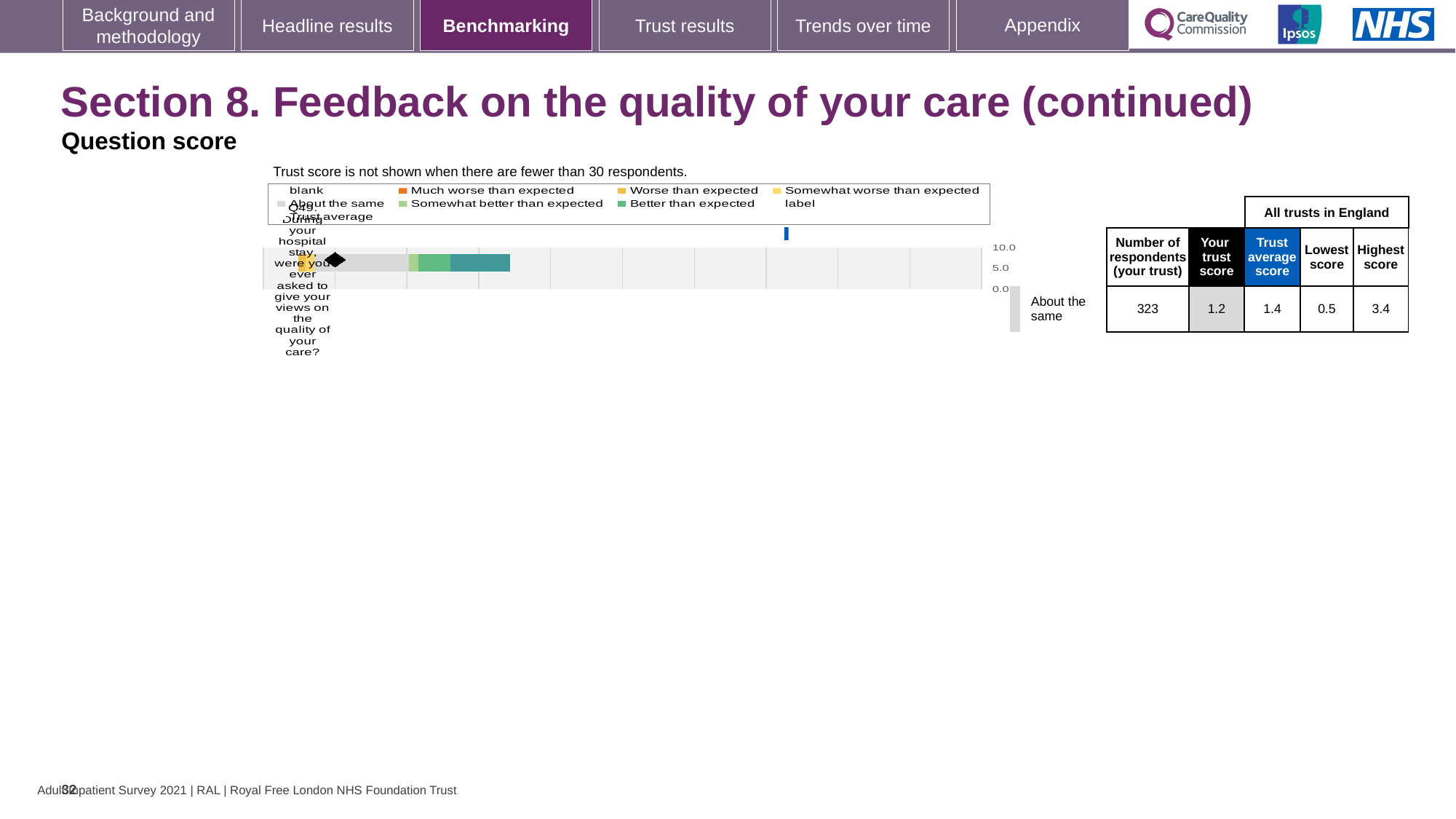
How many survey questions are plotted on the chart? 1 What benchmark category is the trust's Q49 result labelled as? About the same What is the lowest score among all trusts in England for Q49? 0.5 What is the highest score among all trusts in England for Q49? 3.4 What is the trust average score for Q49? 1.4 What is the trust score for Q49 shown in the table next to the chart? 1.2 Which is larger for Q49: the trust's own score or the trust average score? Trust average score By how much does the trust average score exceed the trust's own score for Q49? 0.2 How many respondents from the trust answered Q49? 323 What kind of chart is used to show the Q49 benchmarking result? bar chart According to the note above the chart, when is the trust score not shown? When there are fewer than 30 respondents What is the difference between the highest and lowest scores for Q49 across all trusts in England? 2.9